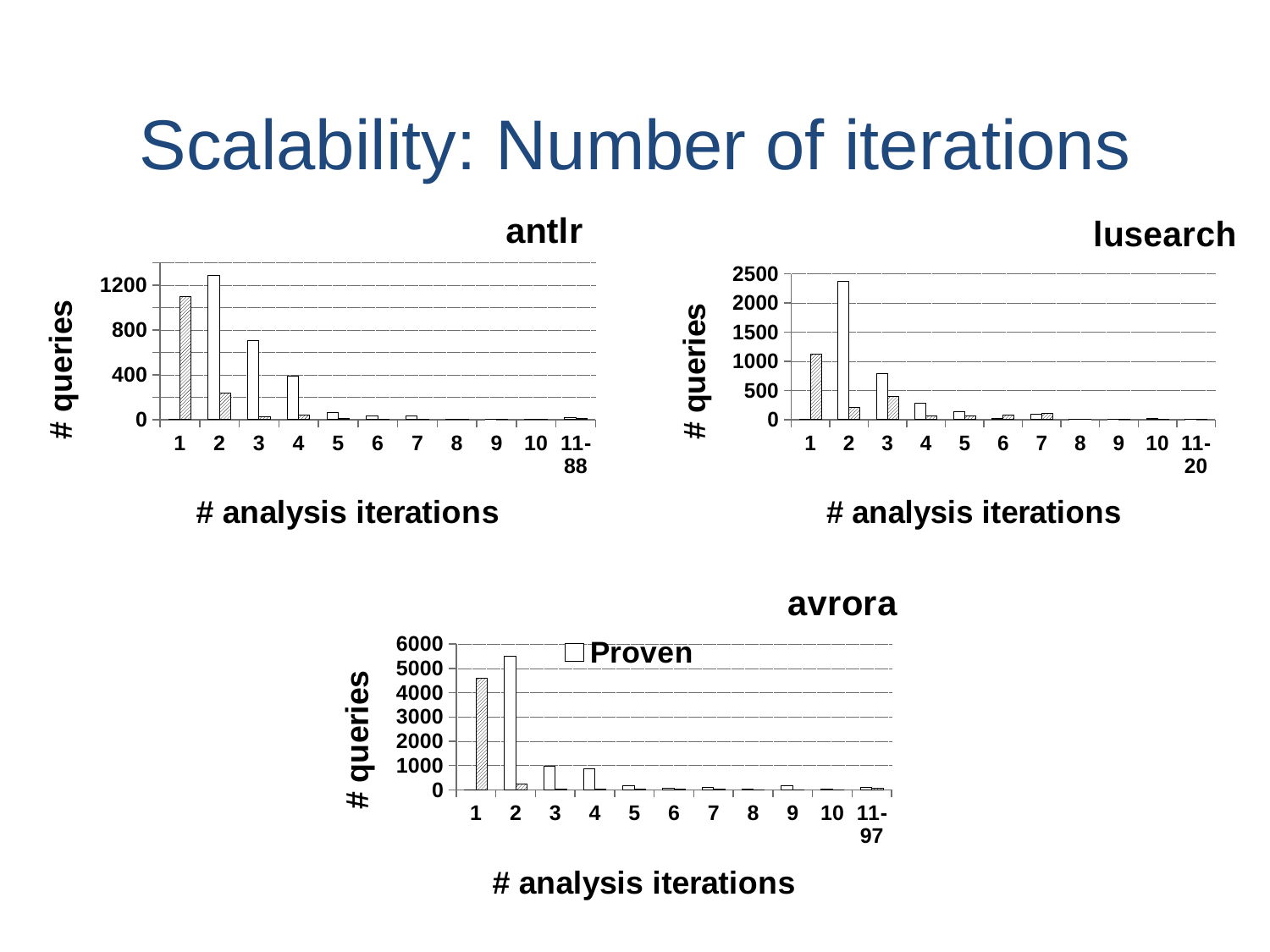
What is the y-axis label on the lusearch chart? # queries In the avrora chart, is the hatched bar at iteration 1 greater or less than 5000? less In the avrora chart, do the bar heights generally rise or fall as the number of analysis iterations increases beyond 2? fall How many categories are shown on the x axis of the lusearch chart? 11 In the avrora chart, is the tallest bar at iteration 2 greater or less than 5000? greater In the antlr chart, is the hatched bar at iteration 1 greater or less than 800? greater What kind of chart is the antlr chart? bar chart In the lusearch chart, which analysis iteration has the tallest bar? 2 In the antlr chart, which is taller: the white bar at iteration 2 or the white bar at iteration 3? the white bar at iteration 2 What series name is shown in the legend of the avrora chart? Proven